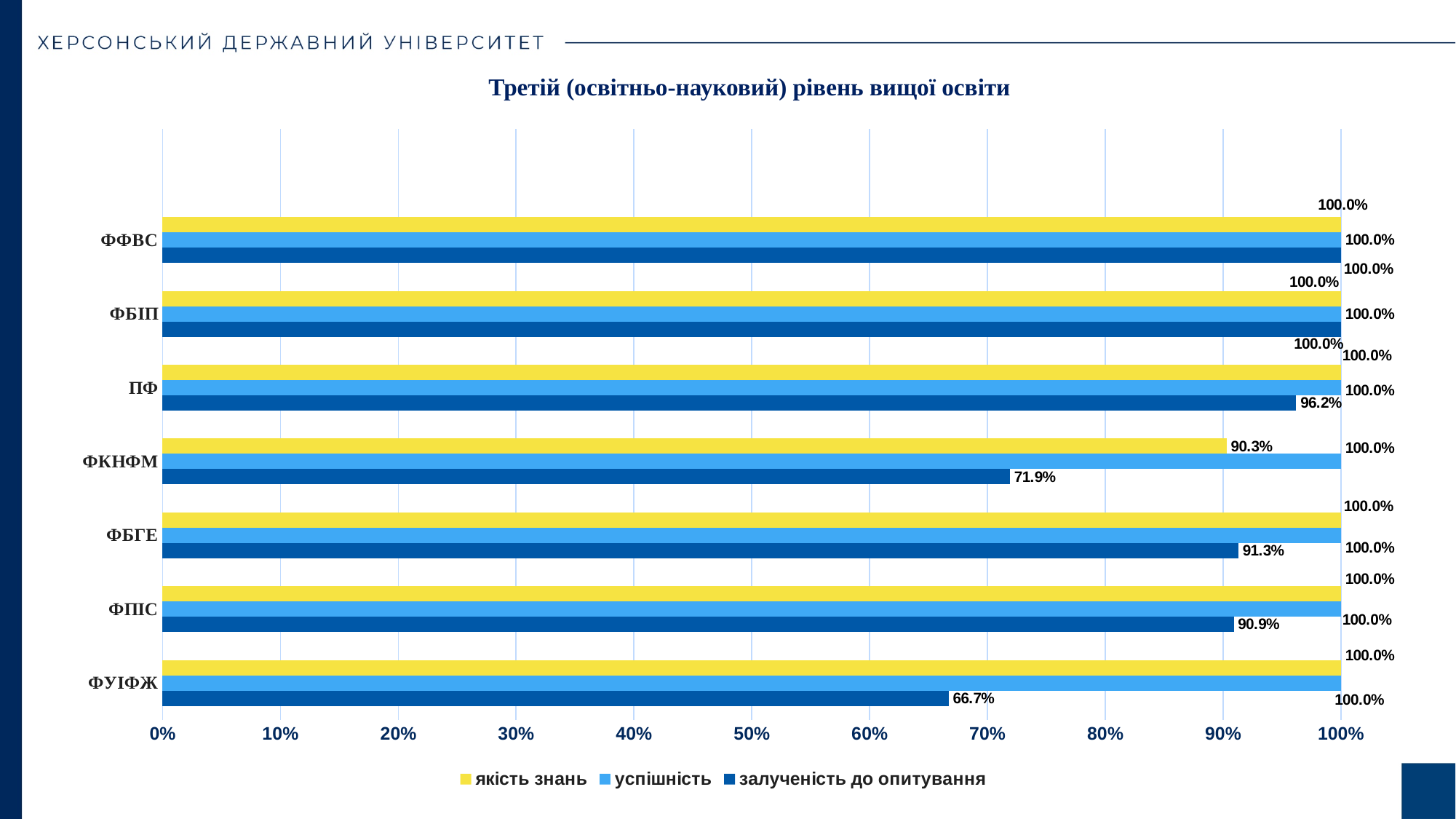
What is the value of залученість до опитування for ФКНФМ? 71.9% Which category has the lowest value for залученість до опитування? ФУІФЖ What is the value of якість знань for ФКНФМ? 90.3% What is the difference between залученість до опитування for ФБГЕ and for ФПІС? 0.4% For ФКНФМ, what is the difference between якість знань and залученість до опитування? 18.4% What is the value of залученість до опитування for ПФ? 96.2% What is the value of залученість до опитування for ФУІФЖ? 66.7% Is the value of залученість до опитування for ФУІФЖ greater or less than 70%? less Which is larger: залученість до опитування for ФКНФМ or for ФУІФЖ? ФКНФМ How many categories are shown on the chart? 7 How many series does the legend list? 3 What type of chart is shown on the slide? bar chart